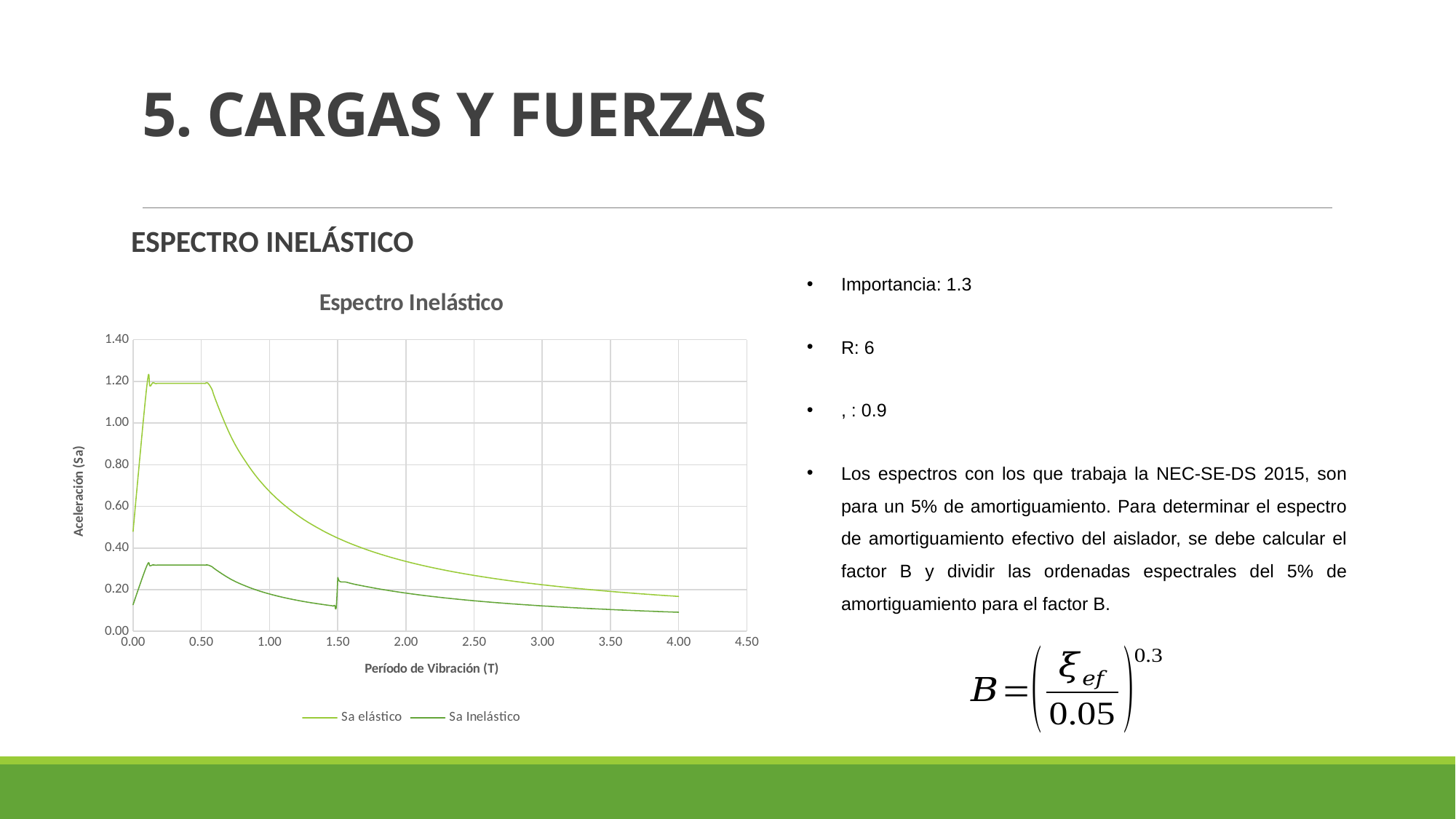
Between periods of 0.10 and 0.50, does the Sa Inelástico curve rise, fall, or stay flat? Stay flat Is the value of Sa elástico at a period of 0.50 greater or less than 1.00? greater What are the two series named in the chart legend? Sa elástico and Sa Inelástico At a period of 1.00, which series has the higher value, Sa elástico or Sa Inelástico? Sa elástico How many series does the chart legend list? 2 Is the value of Sa Inelástico at a period of 0.50 greater or less than 0.40? less What is the title of the chart? Espectro Inelástico Is the value of Sa elástico at a period of 2.00 greater or less than 0.60? less What kind of chart is shown on the slide? Line chart Between periods of 1.00 and 4.00, does the Sa elástico curve rise or fall? Fall